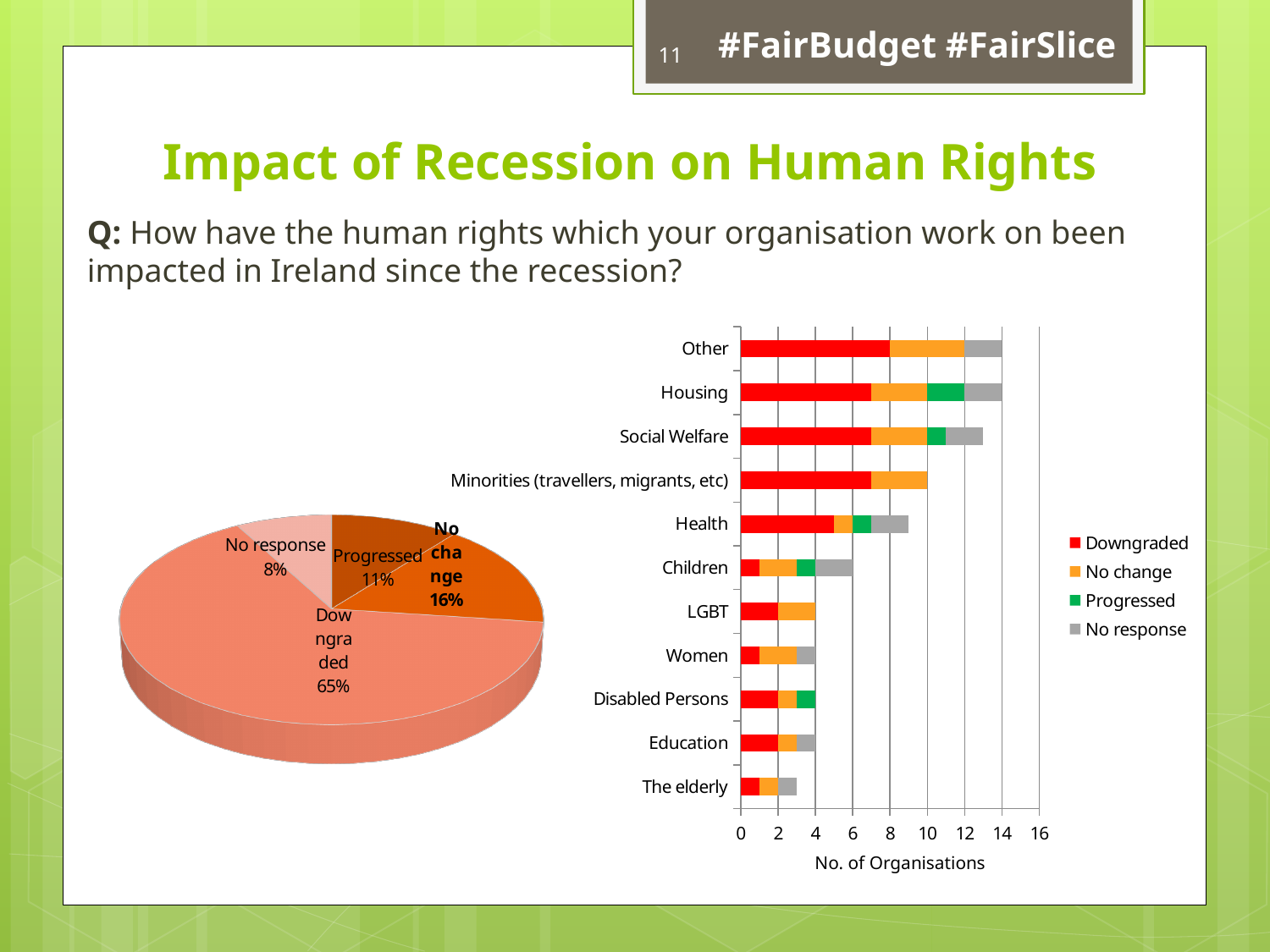
On the bar chart on the right, is the total number of organisations for The elderly greater or less than 4? less What kind of chart is the chart on the right of the slide? Stacked bar chart On the bar chart on the right, how many categories are shown on the vertical axis? 11 On the pie chart, what share of responses is Downgraded? 65% On the pie chart, which slice is the largest? Downgraded On the bar chart on the right, what is the label of the horizontal axis? No. of Organisations On the pie chart, what share of responses is Progressed? 11% On the pie chart, which slice is the smallest? No response On the bar chart on the right, how many series does the legend list? 4 On the pie chart, how many percentage points larger is Downgraded than No change? 49 percentage points On the pie chart, what share of responses is No change? 16% On the bar chart on the right, is the total number of organisations for Health greater or less than 8? greater